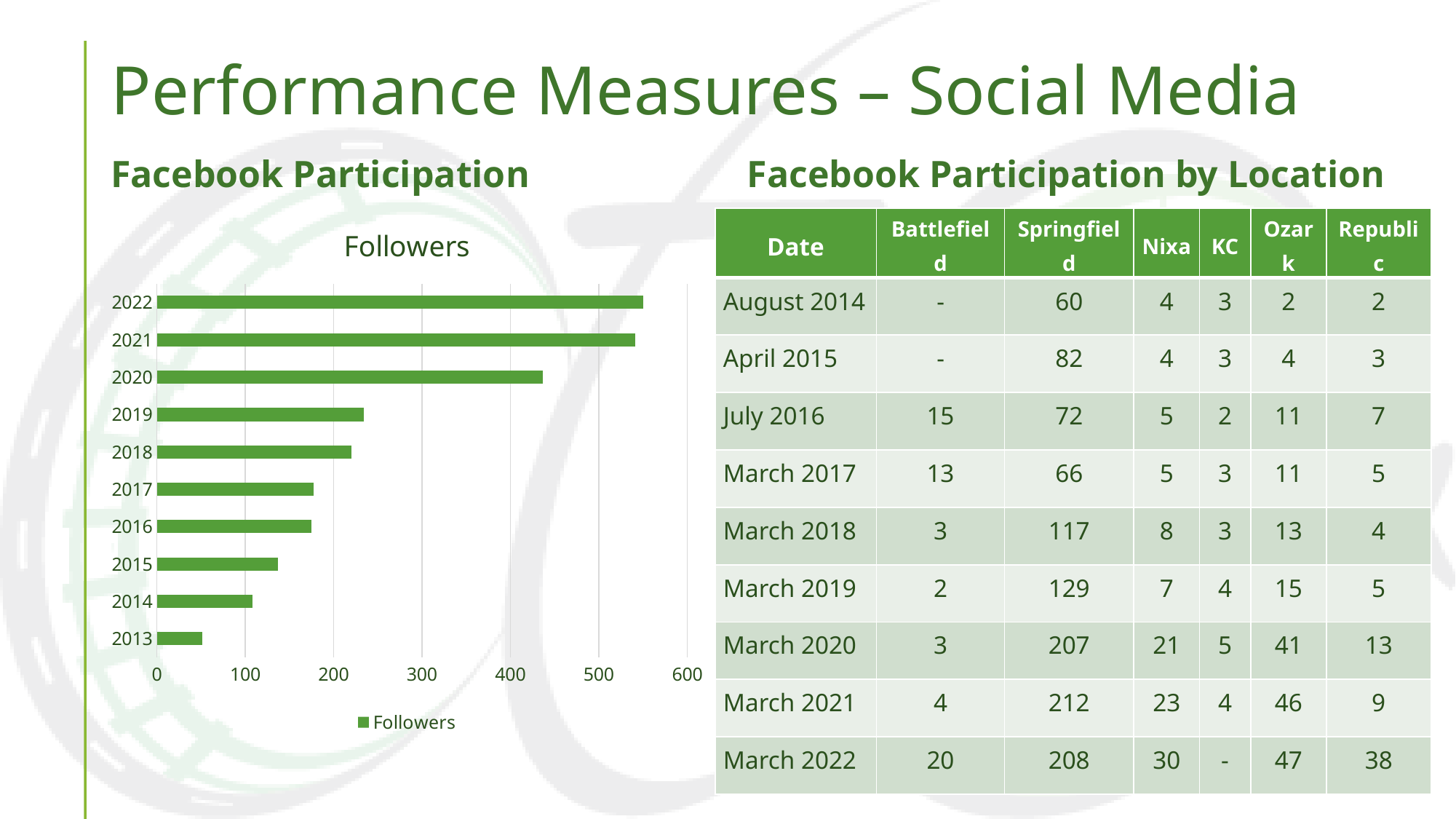
Is the value for 2013 on the Followers chart greater or less than 100? less How many years are shown on the Followers chart? 10 Is the value for 2017 on the Followers chart greater or less than 200? less How many series does the legend of the Followers chart list? 1 On the Followers chart, which has more followers, 2018 or 2015? 2018 Which year has the lowest number of followers on the Followers chart? 2013 What kind of chart is the Followers chart? bar chart Do the follower values generally rise or fall from 2013 to 2022 on the Followers chart? rise Is the value for 2022 on the Followers chart greater or less than 500? greater On the Followers chart, which has more followers, 2020 or 2019? 2020 What is the title of the bar chart on the slide? Followers